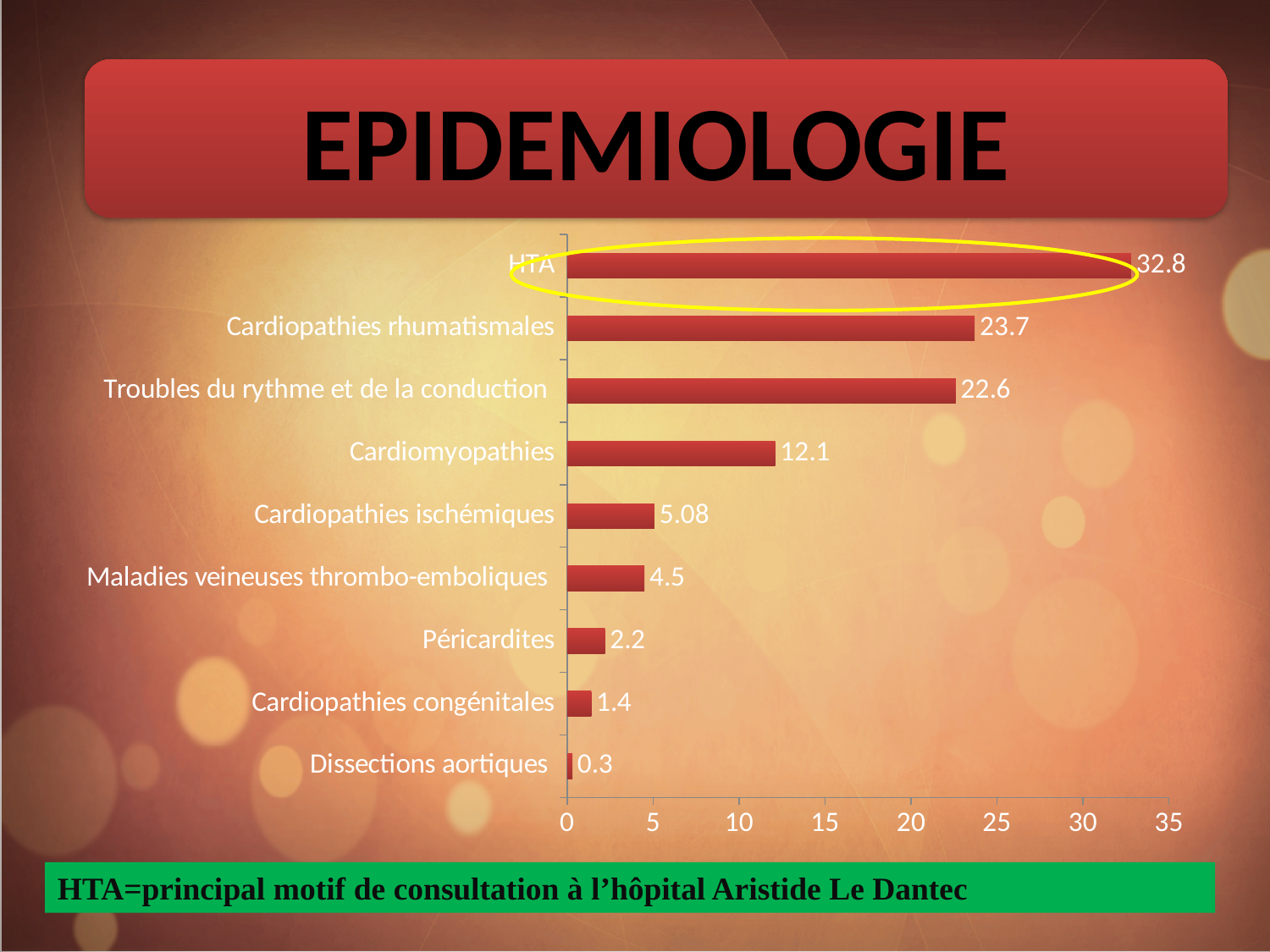
What is the difference between the values for HTA and Cardiopathies rhumatismales? 9.1 Is the value for Cardiopathies rhumatismales greater or less than 20? greater Which category has the lowest value? Dissections aortiques What is the value for Cardiopathies ischémiques? 5.08 Which category is circled in yellow on the chart? HTA What is the value for Cardiomyopathies? 12.1 Which category has the highest value? HTA What kind of chart is shown on the slide? bar chart How many categories are shown in the chart? 9 What is the value for Péricardites? 2.2 Which is larger, the value for Troubles du rythme et de la conduction or the value for Cardiomyopathies? Troubles du rythme et de la conduction What is the value for HTA? 32.8